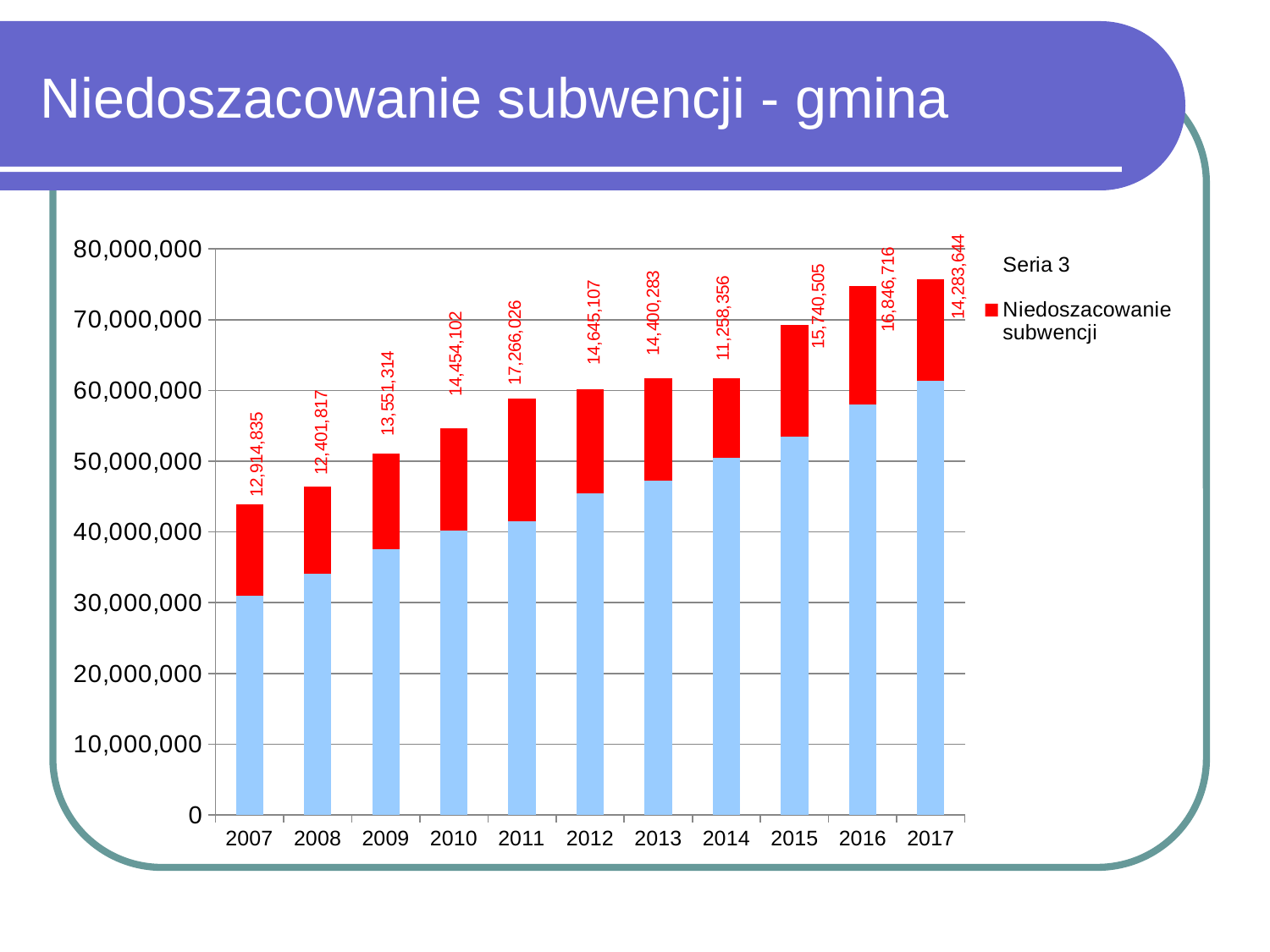
How many years are shown on the x axis? 11 How many series does the legend list? 2 What is the value of Niedoszacowanie subwencji for 2011? 17,266,026 What is the value of Niedoszacowanie subwencji for 2007? 12,914,835 Which year has the lowest value of Niedoszacowanie subwencji? 2014 Is the total height of the stacked bar for 2017 greater or less than 70,000,000? greater What is the value of Niedoszacowanie subwencji for 2017? 14,283,644 Which year has a larger Niedoszacowanie subwencji value, 2016 or 2015? 2016 Which year has the highest value of Niedoszacowanie subwencji? 2011 Is the total height of the stacked bar for 2007 greater or less than 50,000,000? less What is the difference between the Niedoszacowanie subwencji values for 2011 and 2014? 6,007,670 What kind of chart is shown on the slide? Stacked bar chart